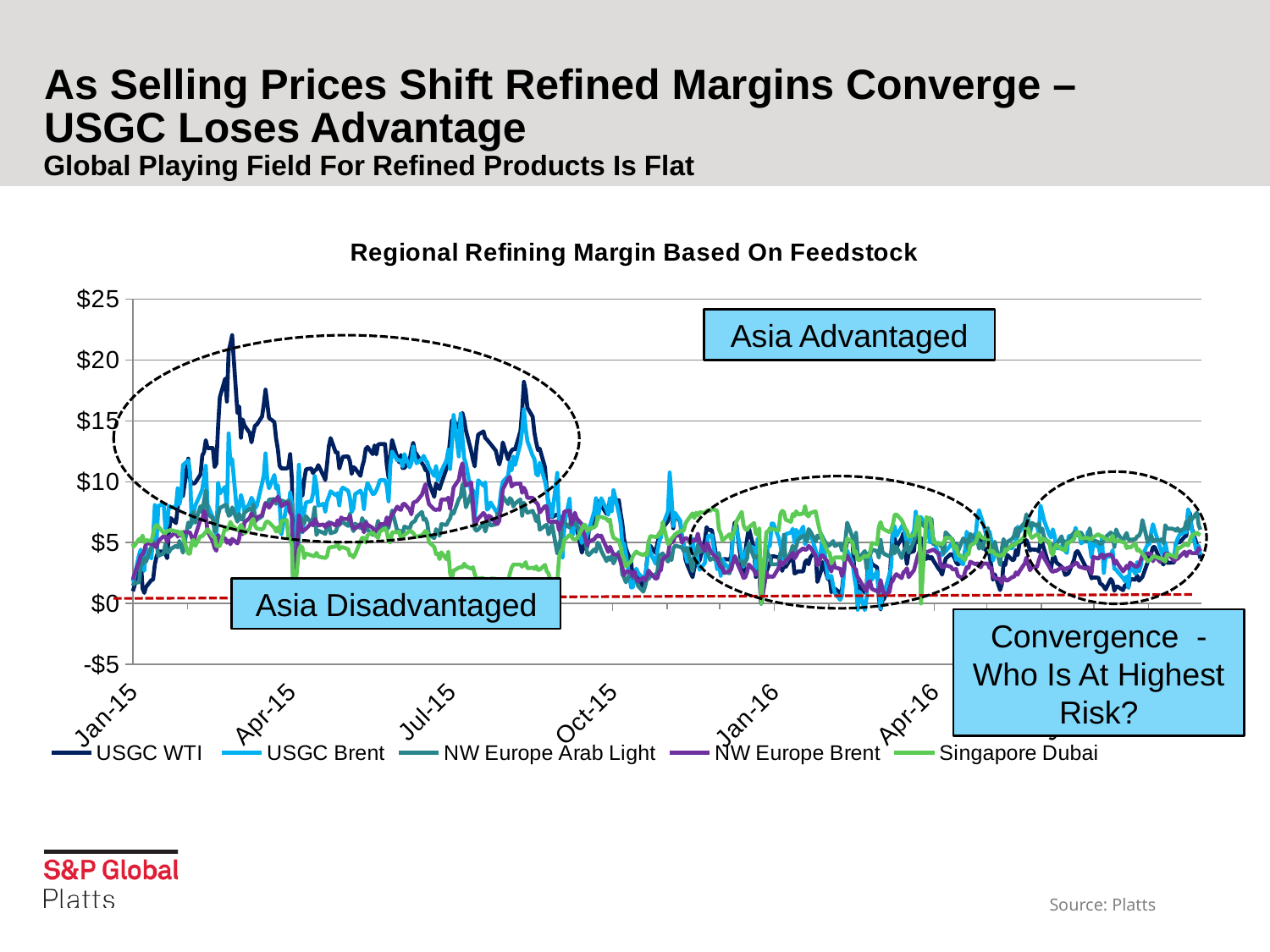
What kind of chart is shown on the slide? Line chart How many series does the legend of the chart list? 5 Is the value of the USGC WTI series around Jan-16 greater or less than $10? less Which series is listed last in the chart legend? Singapore Dubai Is the value of the Singapore Dubai series around Jul-15 greater or less than $5? less What is the lowest value shown on the vertical axis of the chart? -$5 Which series reaches the highest value on the chart? USGC WTI Is the peak value of the USGC WTI series in early 2015 greater or less than $20? greater Around Apr-15, which series has the higher value: USGC WTI or Singapore Dubai? USGC WTI What is the highest value shown on the vertical axis of the chart? $25 Does the USGC WTI series generally rise or fall from early 2015 to mid 2016? Fall